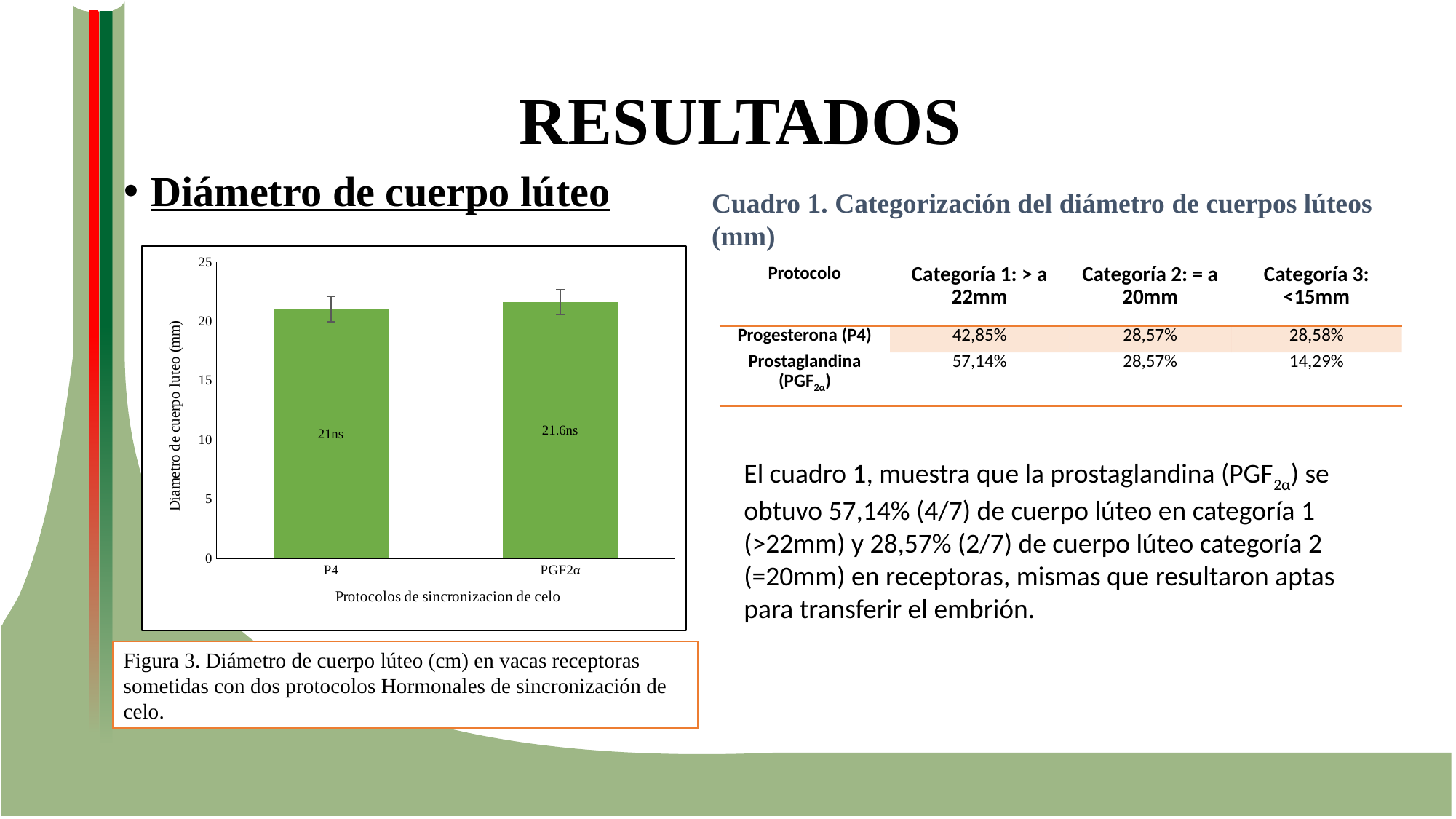
Is the value for PGF2α larger or smaller than the value for P4? larger What is the label of the vertical axis of the bar chart? Diametro de cuerpo luteo (mm) What is the difference between the PGF2α value and the P4 value in the bar chart? 0.6 What is the value shown for P4 in the bar chart? 21ns Which protocol has the higher bar in the chart? PGF2α Is the value for P4 greater or less than 20? greater What is the value shown for PGF2α in the bar chart? 21.6ns Is the value for PGF2α greater or less than 25? less Which protocol has the lower bar in the chart? P4 How many protocols (categories) are plotted in the bar chart? 2 What kind of chart is shown on the slide? bar chart What is the label of the horizontal axis of the bar chart? Protocolos de sincronizacion de celo